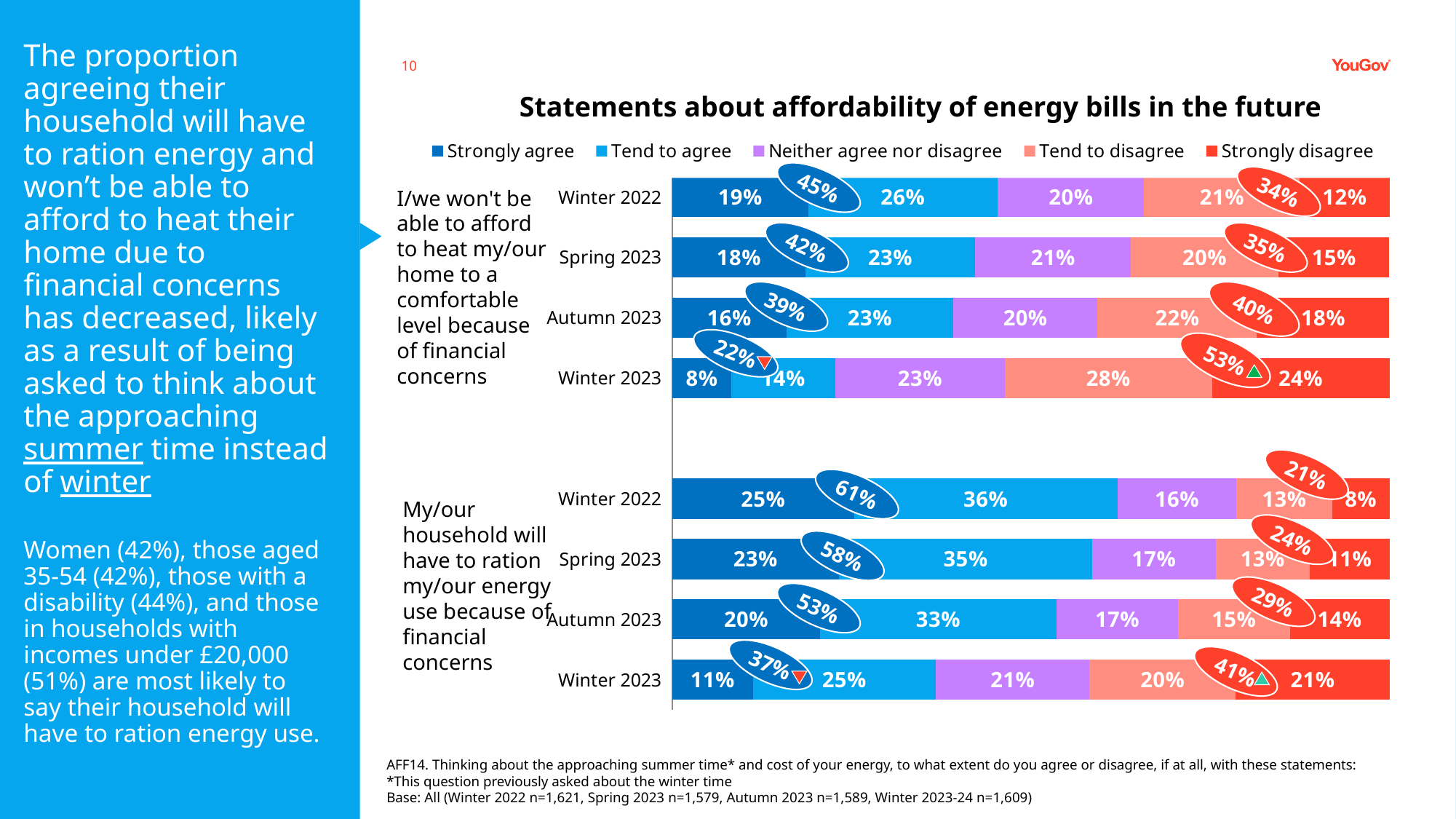
How many series does the legend list? 5 What percentage tend to agree in Winter 2022 that their household will have to ration energy use because of financial concerns? 36% What is the 'Neither agree nor disagree' value for Spring 2023 for the statement about having to ration energy use? 17% Which is larger for Winter 2023: the 'Strongly disagree' value for the statement about heating the home or the 'Strongly disagree' value for the statement about rationing energy use? Heating the home (24%) Across the four waves, which wave has the highest 'Strongly agree' value for the statement about having to ration energy use? Winter 2022 What is the difference between the 'Tend to disagree' values for Winter 2023 and Winter 2022 for the statement about not being able to afford to heat the home? 7% What percentage strongly agree in Winter 2023 that they won't be able to afford to heat their home to a comfortable level because of financial concerns? 8% What is the 'Strongly disagree' value for Autumn 2023 for the statement about not being able to afford to heat the home? 18% What type of chart is shown on the slide? Stacked bar chart What is the title of the chart? Statements about affordability of energy bills in the future How does the 'Strongly agree' value for the statement about having to ration energy use change from Winter 2022 to Winter 2023? It falls Across the four waves, which wave has the lowest 'Strongly agree' value for the statement about not being able to afford to heat the home? Winter 2023